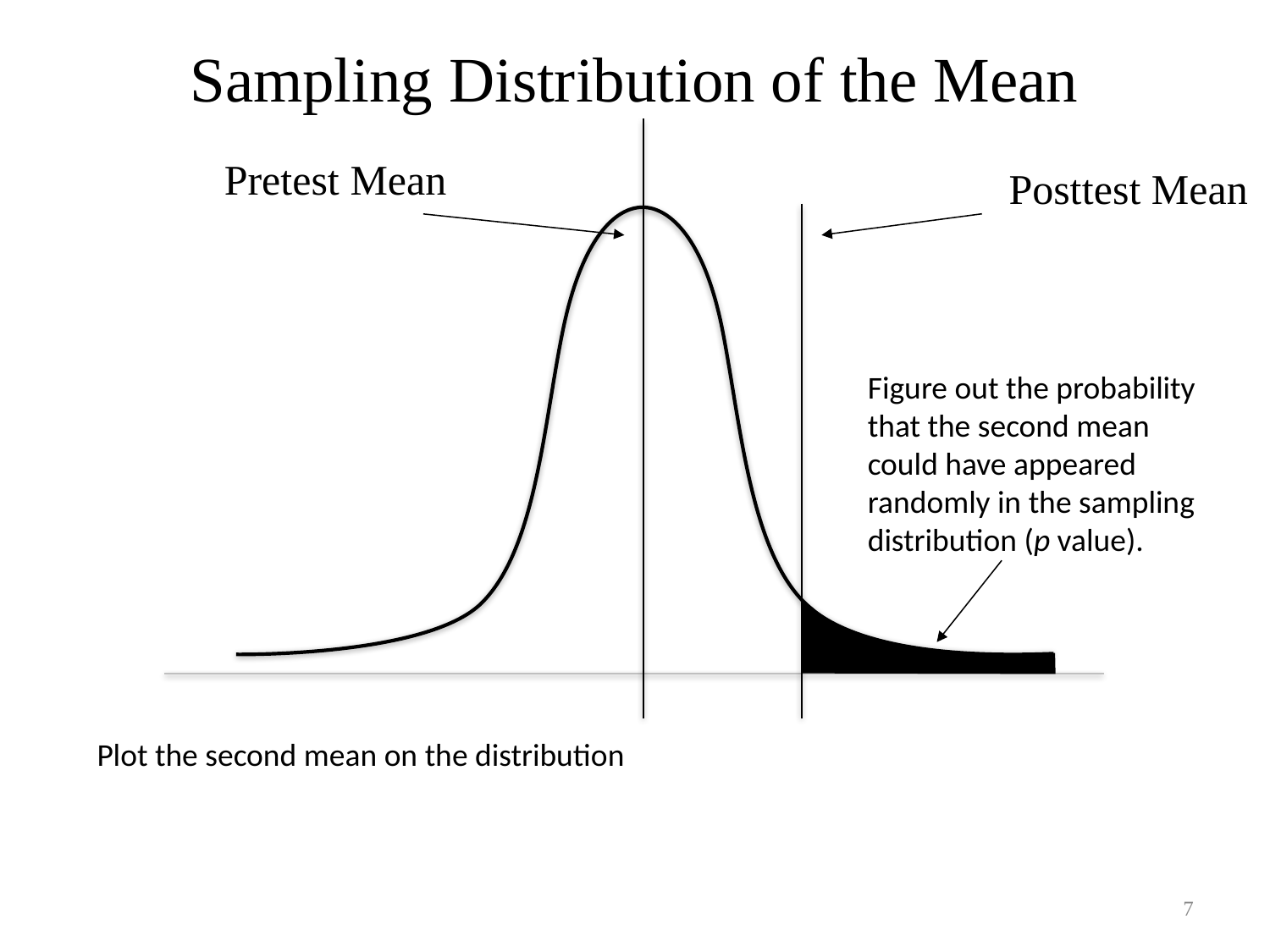
Which labelled mean is located at the peak of the distribution curve? Pretest Mean Does the curve rise or fall as it moves from the Pretest Mean toward the Posttest Mean? Fall How many means are marked with vertical lines on the distribution? 2 Which of the two marked means lies further to the right on the distribution, the Pretest Mean or the Posttest Mean? Posttest Mean What kind of chart is shown on the slide? A line chart (bell-shaped distribution curve) What does the shaded black area to the right of the Posttest Mean represent, according to the slide? The probability that the second mean could have appeared randomly in the sampling distribution (p value) What is the title of the slide containing the chart? Sampling Distribution of the Mean